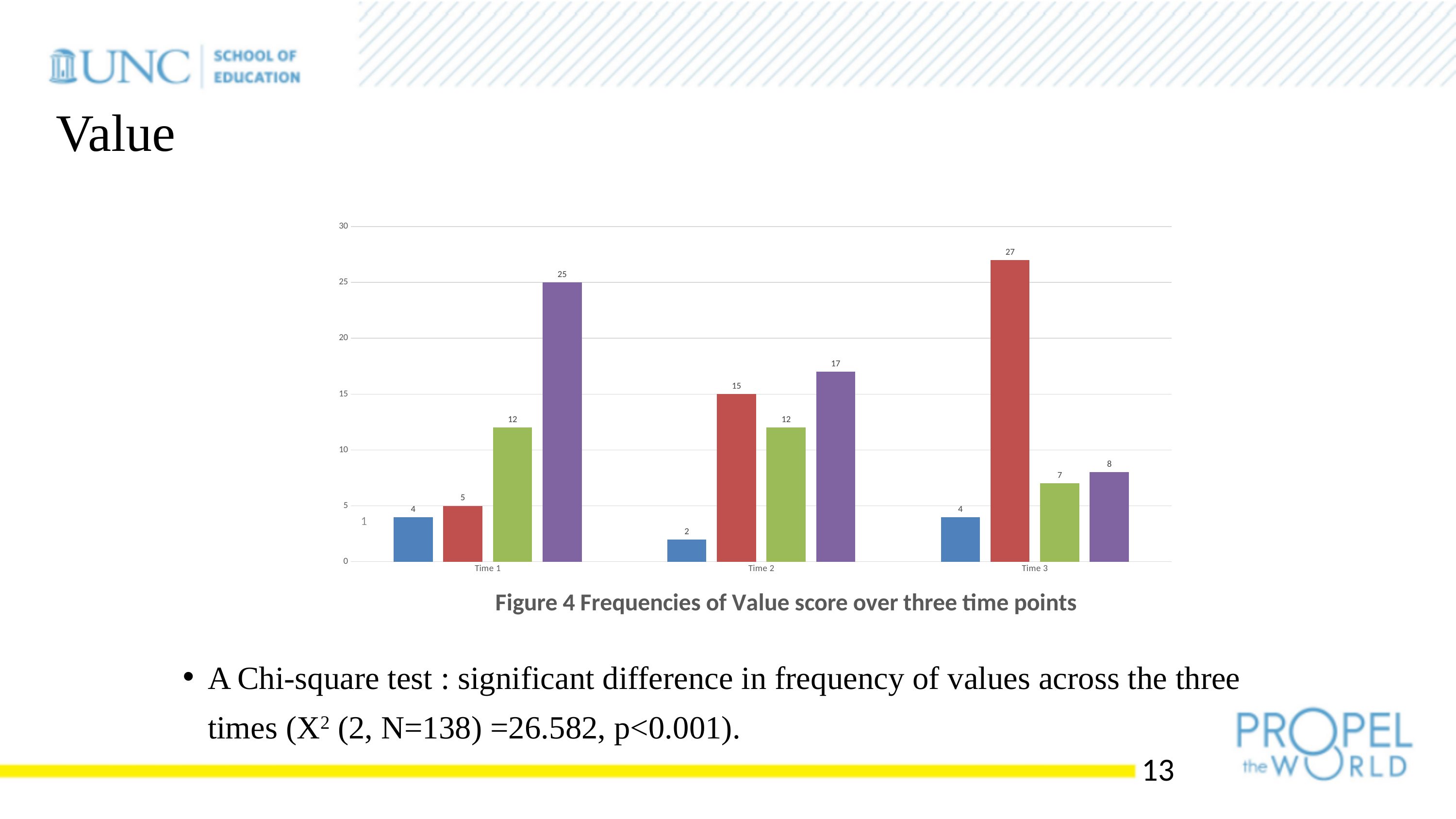
What is the value of the green bar at Time 3? 7 Does the purple bar at Time 1 rise or fall across Time 1, Time 2 and Time 3? Fall What type of chart is shown on the slide? Bar chart Which time point has the lowest purple bar? Time 3 How many time points (categories) are shown on the x axis of the chart? 3 What is the difference between the purple bar at Time 1 and the purple bar at Time 2? 8 What is the value of the purple bar at Time 1? 25 Which is larger at Time 2: the red bar or the green bar? The red bar What is the caption of the chart on the slide? Figure 4 Frequencies of Value score over three time points Which time point has the highest red bar? Time 3 What is the value of the blue bar at Time 2? 2 What is the value of the red bar at Time 3? 27